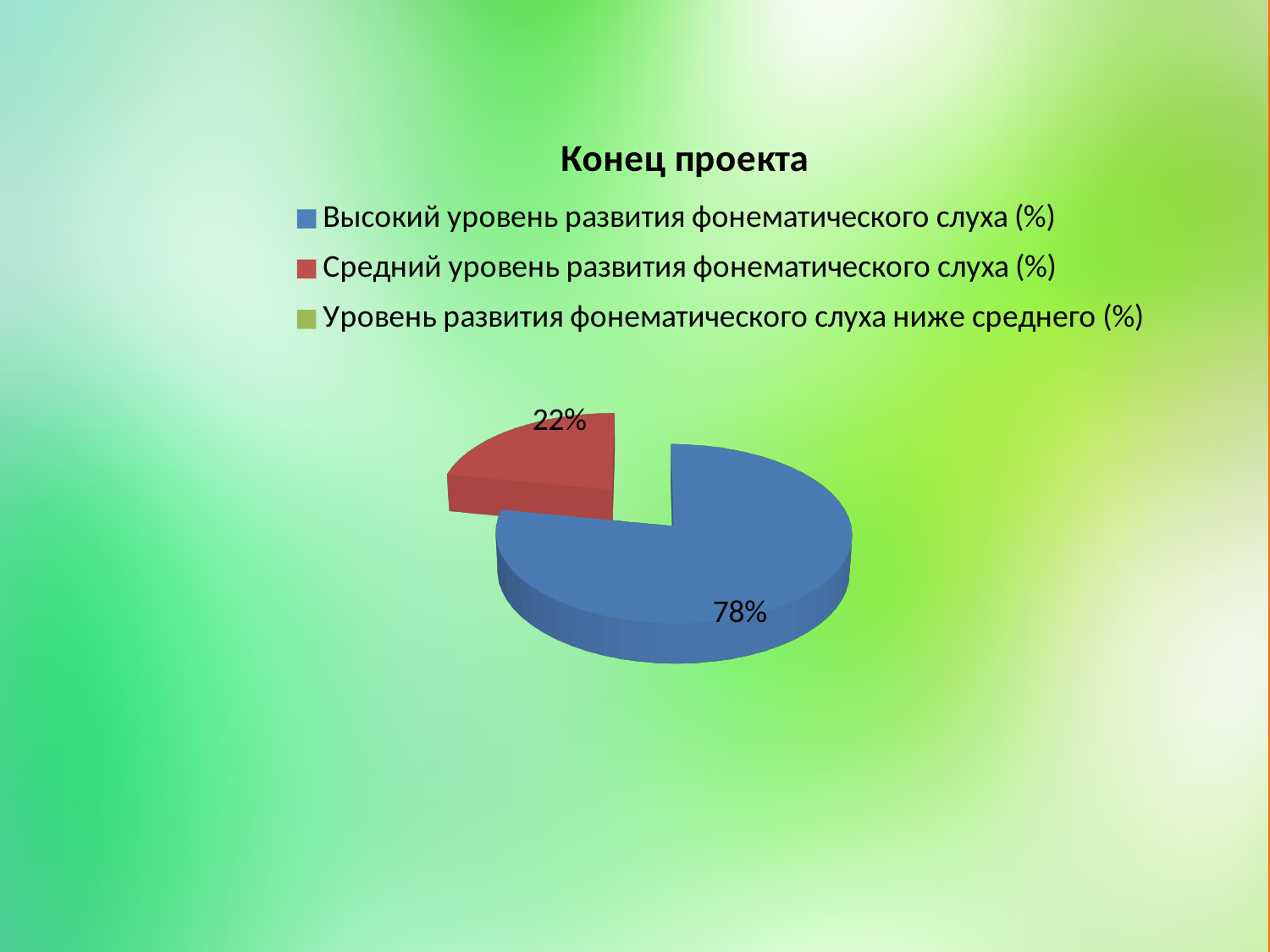
How many entries does the legend list? 3 What is the title of the chart? Конец проекта Is the value for Высокий уровень развития фонематического слуха (%) larger than the value for Средний уровень развития фонематического слуха (%)? yes What kind of chart is shown on the slide? pie chart What is the value for Высокий уровень развития фонематического слуха (%)? 78% How many slices with data labels are visible in the pie? 2 Which colour represents Средний уровень развития фонематического слуха (%) in the legend? red Which of the two labelled slices is smaller, the blue one or the red one? the red one What is the value for Средний уровень развития фонематического слуха (%)? 22% Which category has the largest slice of the pie? Высокий уровень развития фонематического слуха (%) What is the difference between the value for Высокий уровень развития фонематического слуха (%) and the value for Средний уровень развития фонематического слуха (%)? 56%